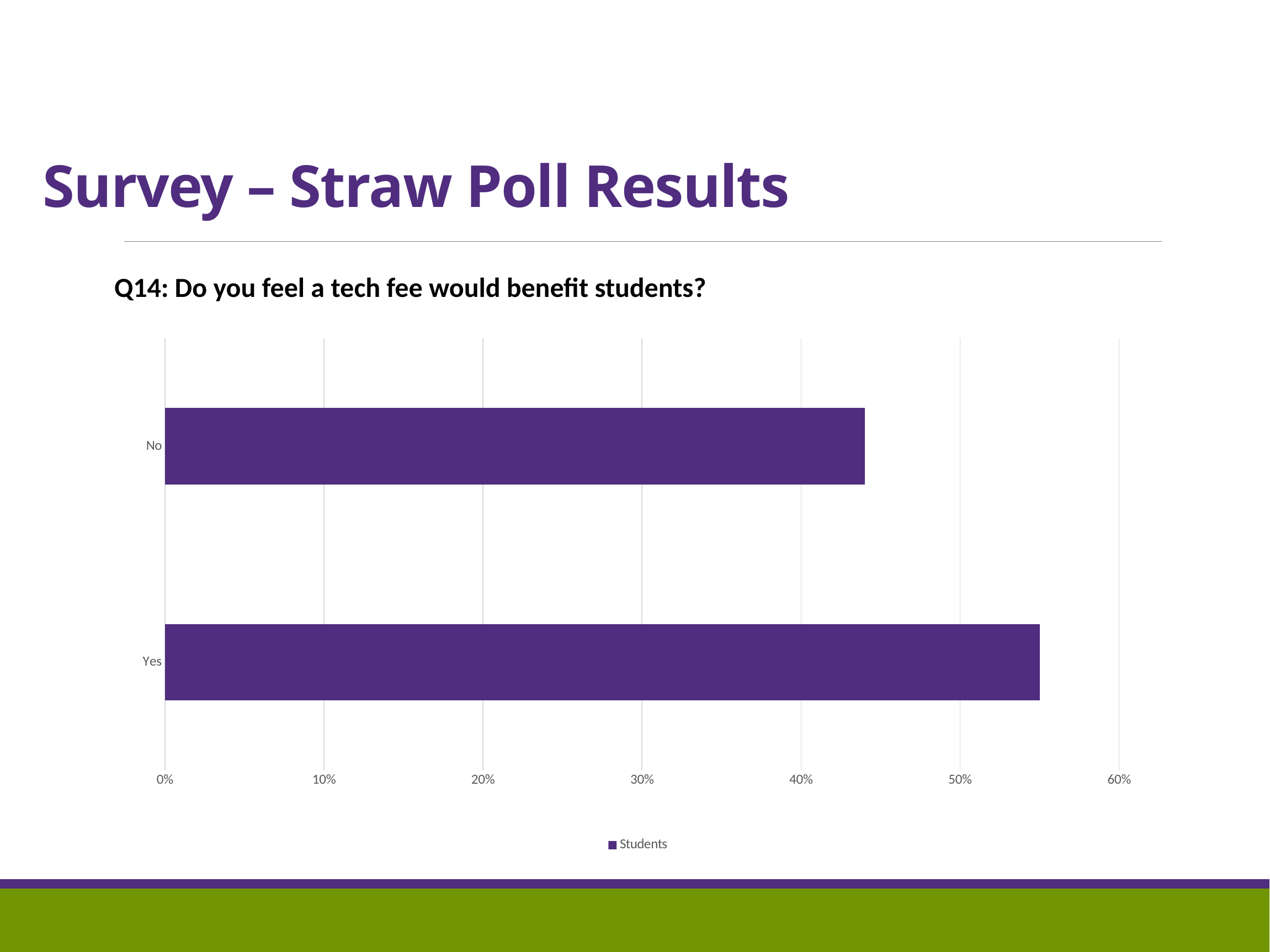
Which is larger, the value for Yes or the value for No? Yes Which category has the highest value? Yes Which category has the lowest value? No Is the value for Yes greater or less than 50%? greater Is the value for No greater or less than 50%? less What is the name of the series listed in the legend? Students What kind of chart is shown on the slide? bar chart Is the value for No greater or less than 40%? greater How many series does the legend list? 1 How many categories does the chart show? 2 What question is the chart about, as stated above it? Q14: Do you feel a tech fee would benefit students?